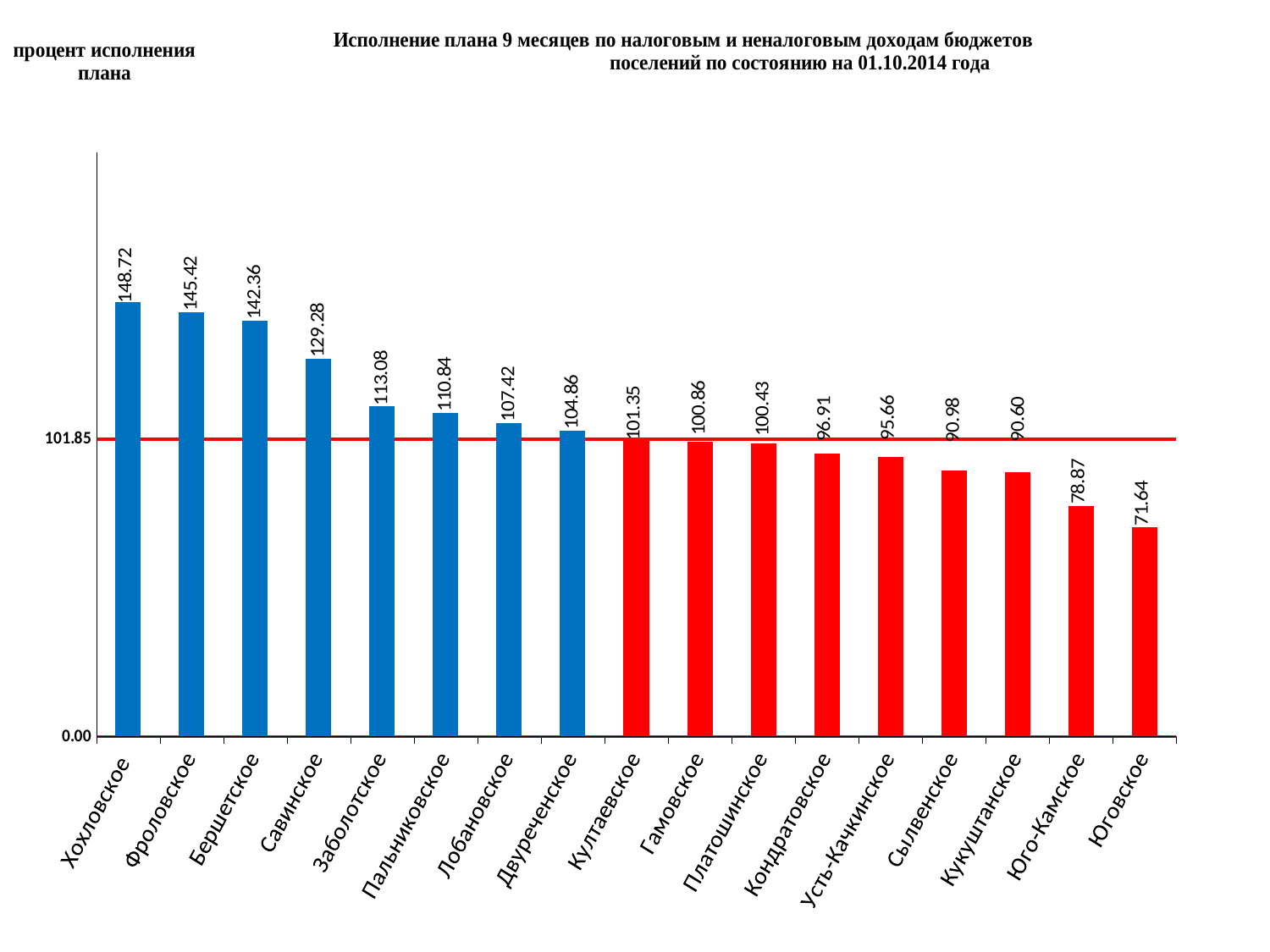
Which category has the lowest value? Юговское What kind of chart is shown on the slide? Bar chart How many categories are shown on the x axis? 17 What is the value for Савинское? 129.28 What is the difference between the values for Хохловское and Юговское? 77.08 Do the values rise or fall from left to right along the x axis? Fall What is the difference between the values for Савинское and Заболотское? 16.20 Which category has the highest value? Хохловское Which is larger, the value for Бершетское or the value for Лобановское? Бершетское What is the value for Хохловское? 148.72 What is the value for Усть-Качкинское? 95.66 What value is marked by the horizontal red line on the chart? 101.85